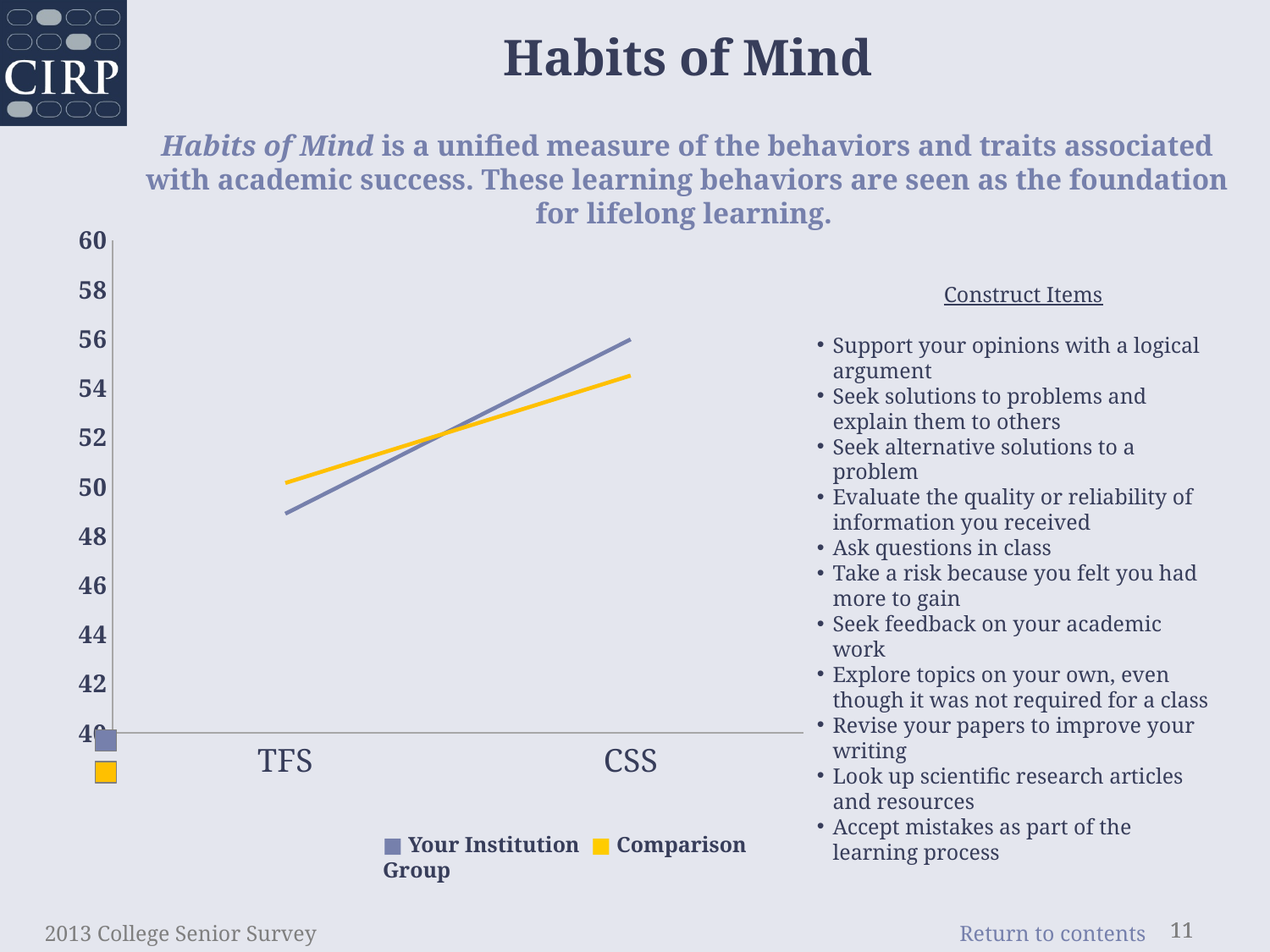
At CSS, which series has the higher value, Your Institution or Comparison Group? Your Institution Which series is drawn in yellow on the chart? Comparison Group Is the value for Your Institution at CSS greater or less than 54? greater What kind of chart is shown on the slide? line chart Does the Your Institution line rise or fall from TFS to CSS? rise At TFS, which series has the higher value, Your Institution or Comparison Group? Comparison Group Does the Comparison Group line rise or fall from TFS to CSS? rise How many series does the chart legend list? 2 What are the two categories on the x axis of the chart? TFS and CSS Is the value for Comparison Group at CSS greater or less than 56? less How many categories are shown on the x axis of the chart? 2 Is the value for Your Institution at TFS greater or less than 50? less